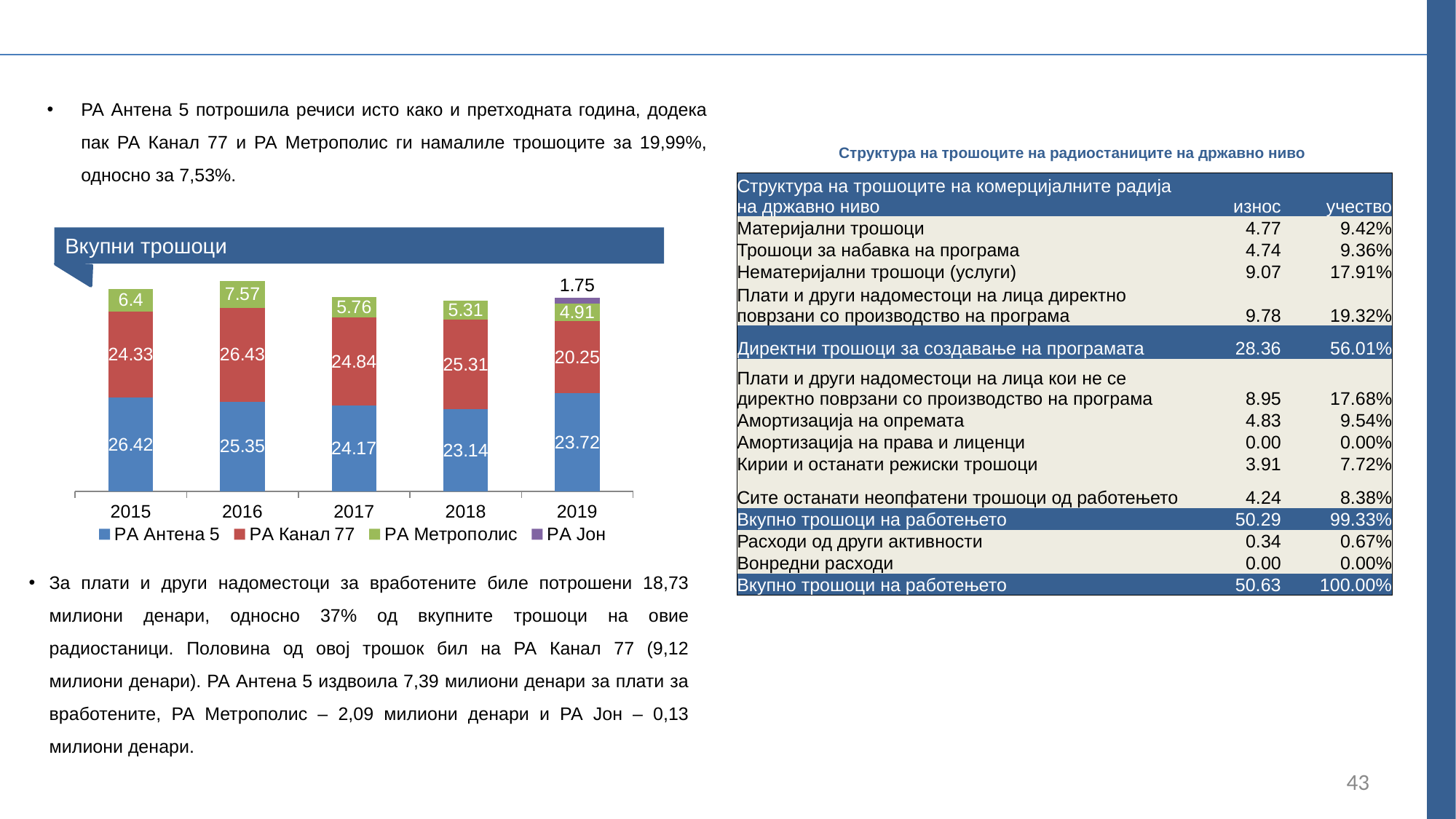
What kind of chart is the "Вкупни трошоци" chart? stacked bar chart In 2017, which is larger in the "Вкупни трошоци" chart: РА Антена 5 or РА Канал 77? РА Канал 77 In which year is the value for РА Метрополис highest in the "Вкупни трошоци" chart? 2016 What is the value for РА Јон in 2019 in the "Вкупни трошоци" chart? 1.75 How many series does the legend of the "Вкупни трошоци" chart list? 4 What is the difference between the РА Канал 77 values for 2018 and 2019 in the "Вкупни трошоци" chart? 5.06 What is the total of the stacked bar for 2019 in the "Вкупни трошоци" chart? 50.63 What is the value for РА Канал 77 in 2016 in the "Вкупни трошоци" chart? 26.43 How many years are shown on the x axis of the "Вкупни трошоци" chart? 5 In which year is the value for РА Антена 5 lowest in the "Вкупни трошоци" chart? 2018 What is the value for РА Антена 5 in 2015 in the "Вкупни трошоци" chart? 26.42 Which series is shown in green in the "Вкупни трошоци" chart? РА Метрополис